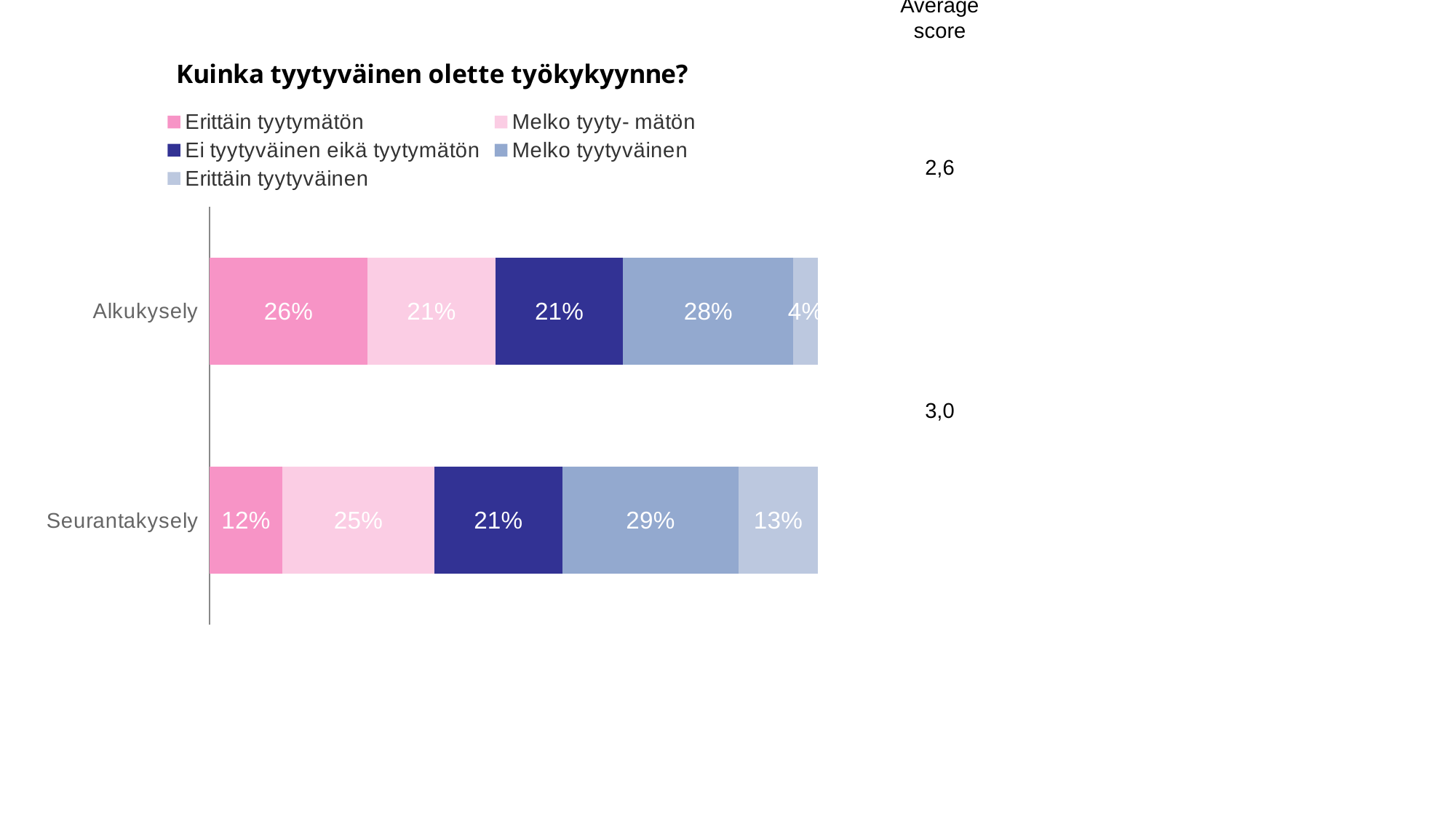
What is the Erittäin tyytyväinen value for Alkukysely? 4% Which response option has the smallest share in the Alkukysely bar? Erittäin tyytyväinen What is the Melko tyytyväinen value for Seurantakysely? 29% Which response option has the largest share in the Seurantakysely bar? Melko tyytyväinen How many categories (bars) are shown in the chart? 2 What is the difference between the Erittäin tyytyväinen shares of Seurantakysely and Alkukysely? 9% What type of chart is shown on the slide? Stacked bar chart Which category has the higher Erittäin tyytymätön share, Alkukysely or Seurantakysely? Alkukysely What is the difference between the Erittäin tyytymätön shares of Alkukysely and Seurantakysely? 14% What percentage of Seurantakysely respondents answered Erittäin tyytyväinen? 13% What percentage of Alkukysely respondents answered Erittäin tyytymätön? 26% How many series does the legend list? 5